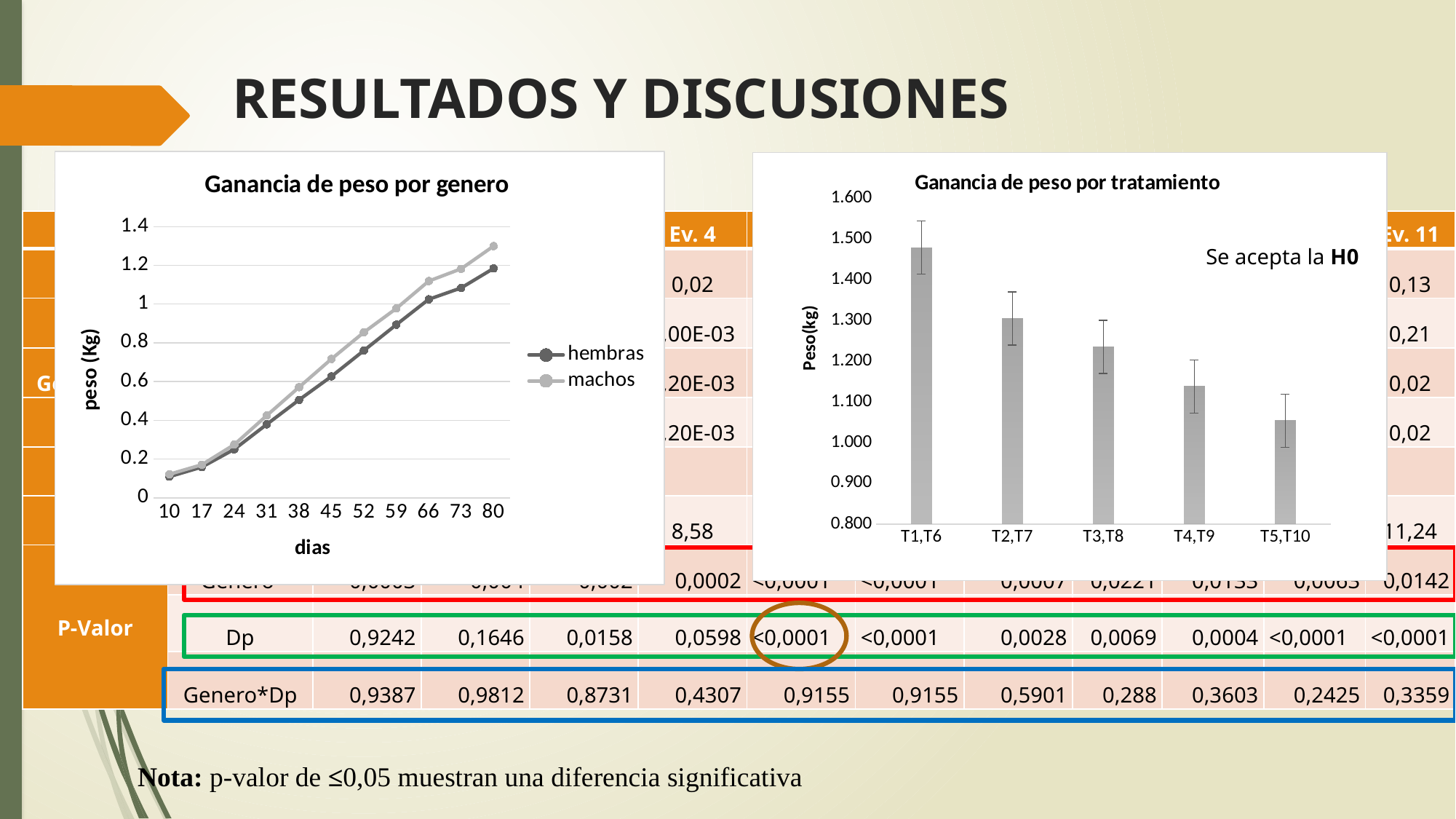
In 'Ganancia de peso por tratamiento', how many treatment categories are shown? 5 What kind of chart is 'Ganancia de peso por genero'? line chart In 'Ganancia de peso por tratamiento', which category has the highest value? T1,T6 In 'Ganancia de peso por genero', is the value for hembras at day 45 greater or less than 0.8? less What kind of chart is 'Ganancia de peso por tratamiento'? bar chart In 'Ganancia de peso por tratamiento', is the value for T5,T10 greater or less than 1.100? less In 'Ganancia de peso por genero', do the values rise or fall as the days increase? rise In 'Ganancia de peso por genero', how many points are plotted along the x axis for each series? 11 In 'Ganancia de peso por genero', how many series does the legend list? 2 In 'Ganancia de peso por genero', which series is higher at day 80, hembras or machos? machos In 'Ganancia de peso por genero', is the value for machos at day 80 greater or less than 1.2? greater In 'Ganancia de peso por tratamiento', which category has the lowest value? T5,T10